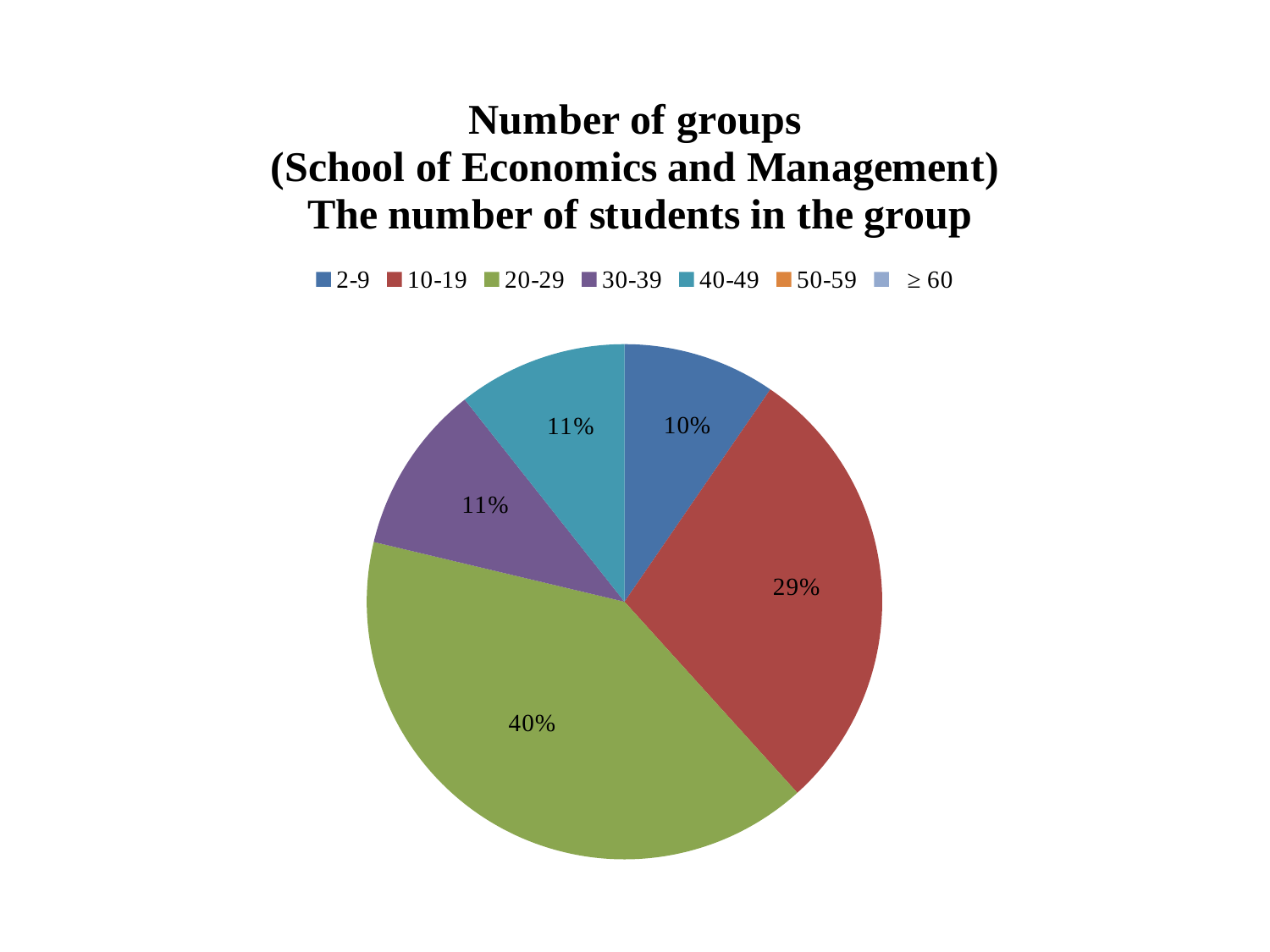
What share of the pie does the 2-9 category have? 10% What is the difference in percentage points between the 20-29 slice and the 10-19 slice? 11 What share of the pie does the 10-19 category have? 29% What colour is the slice for the 20-29 category? green What is the first line of the chart title? Number of groups What kind of chart is shown on the slide? pie chart What share of the pie does the 40-49 category have? 11% How many categories does the legend list? 7 Which category has the largest slice of the pie? 20-29 Which of the two categories has the larger slice, 10-19 or 2-9? 10-19